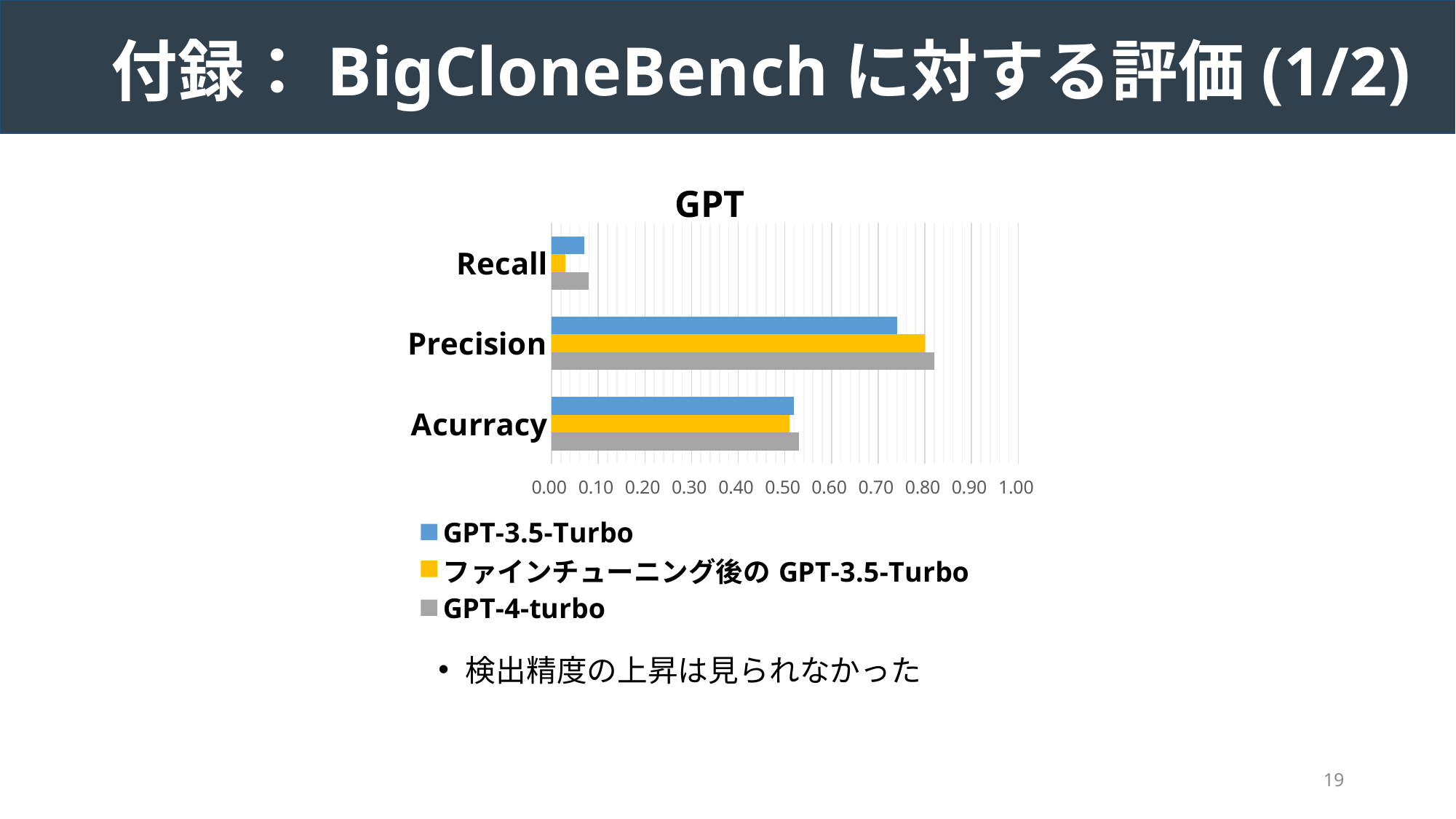
What is the title of the chart? GPT For GPT-4-turbo, which category has the lowest value? Recall For Precision, which is larger: the value for GPT-3.5-Turbo or for ファインチューニング後の GPT-3.5-Turbo? ファインチューニング後の GPT-3.5-Turbo Which series is shown in yellow in the chart? ファインチューニング後の GPT-3.5-Turbo How many categories are shown on the chart's vertical axis? 3 What kind of chart is shown on the slide? bar chart How many series does the chart's legend list? 3 Is the Precision value for GPT-4-turbo greater or less than 0.70? greater Is the Recall value for GPT-4-turbo greater or less than 0.20? less Is the Precision value for GPT-3.5-Turbo greater or less than 0.50? greater For GPT-3.5-Turbo, which category has the highest value? Precision